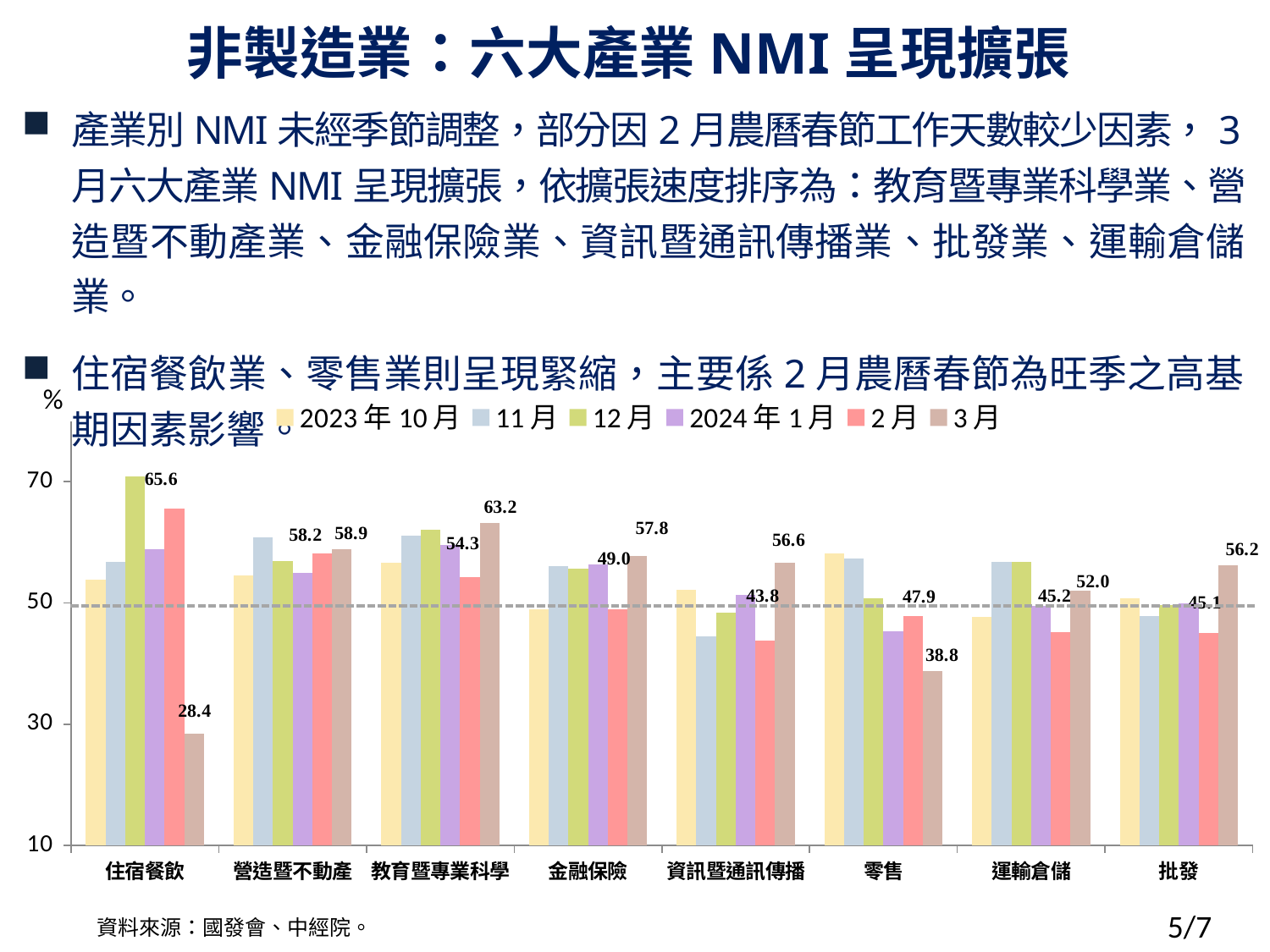
What is the 3月 value for 教育暨專業科學? 63.2 How many industry categories are shown on the x axis? 8 What is the 2月 value for 住宿餐飲? 65.6 Is the 2023年10月 value for 零售 greater or less than 50? greater Which industry has the highest 3月 value? 教育暨專業科學 What kind of chart is shown on the slide? bar chart Which is larger, the 3月 value for 運輸倉儲 or the 3月 value for 零售? 運輸倉儲 How many series does the legend list? 6 Is the 11月 value for 資訊暨通訊傳播 greater or less than 50? less Which industry has the lowest 3月 value? 住宿餐飲 What is the difference between the 3月 and 2月 values for 批發? 11.1 What is the 3月 value for 零售? 38.8